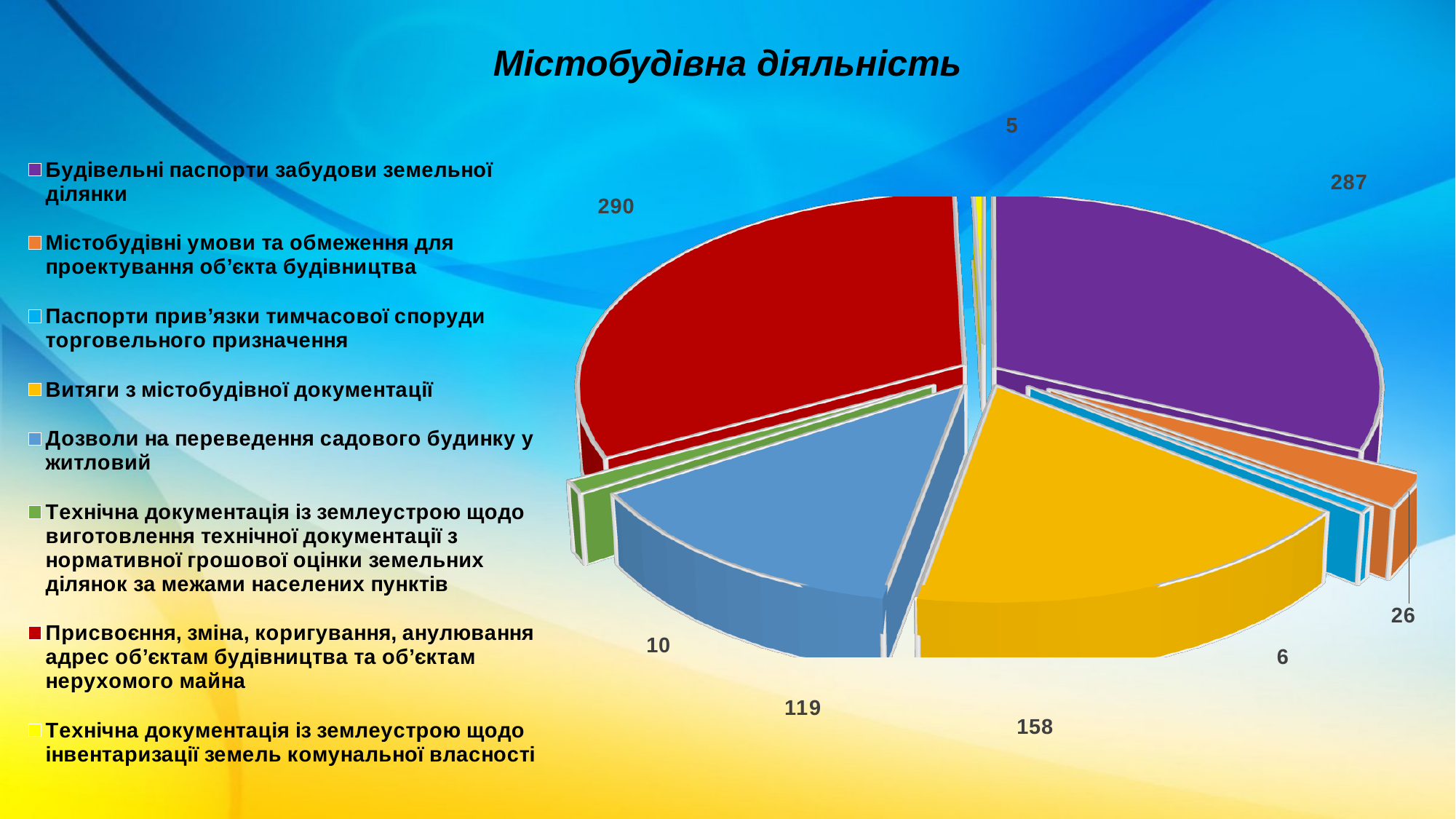
Which category has the largest value? Присвоєння, зміна, коригування, анулювання адрес об'єктам будівництва та об'єктам нерухомого майна Which is larger: the value for "Паспорти прив'язки тимчасової споруди торговельного призначення" or the value for "Технічна документація із землеустрою щодо виготовлення технічної документації з нормативної грошової оцінки земельних ділянок за межами населених пунктів"? Технічна документація із землеустрою щодо виготовлення технічної документації з нормативної грошової оцінки земельних ділянок за межами населених пунктів What is the value for "Дозволи на переведення садового будинку у житловий"? 119 Which category has the smallest value? Технічна документація із землеустрою щодо інвентаризації земель комунальної власності What is the difference between the values for "Витяги з містобудівної документації" and "Дозволи на переведення садового будинку у житловий"? 39 What is the value for "Витяги з містобудівної документації"? 158 What is the value for "Присвоєння, зміна, коригування, анулювання адрес об'єктам будівництва та об'єктам нерухомого майна"? 290 What is the title of the chart? Містобудівна діяльність How many categories does the legend list? 8 What is the value for "Будівельні паспорти забудови земельної ділянки"? 287 What is the value for "Містобудівні умови та обмеження для проектування об'єкта будівництва"? 26 What type of chart is shown on the slide? Pie chart